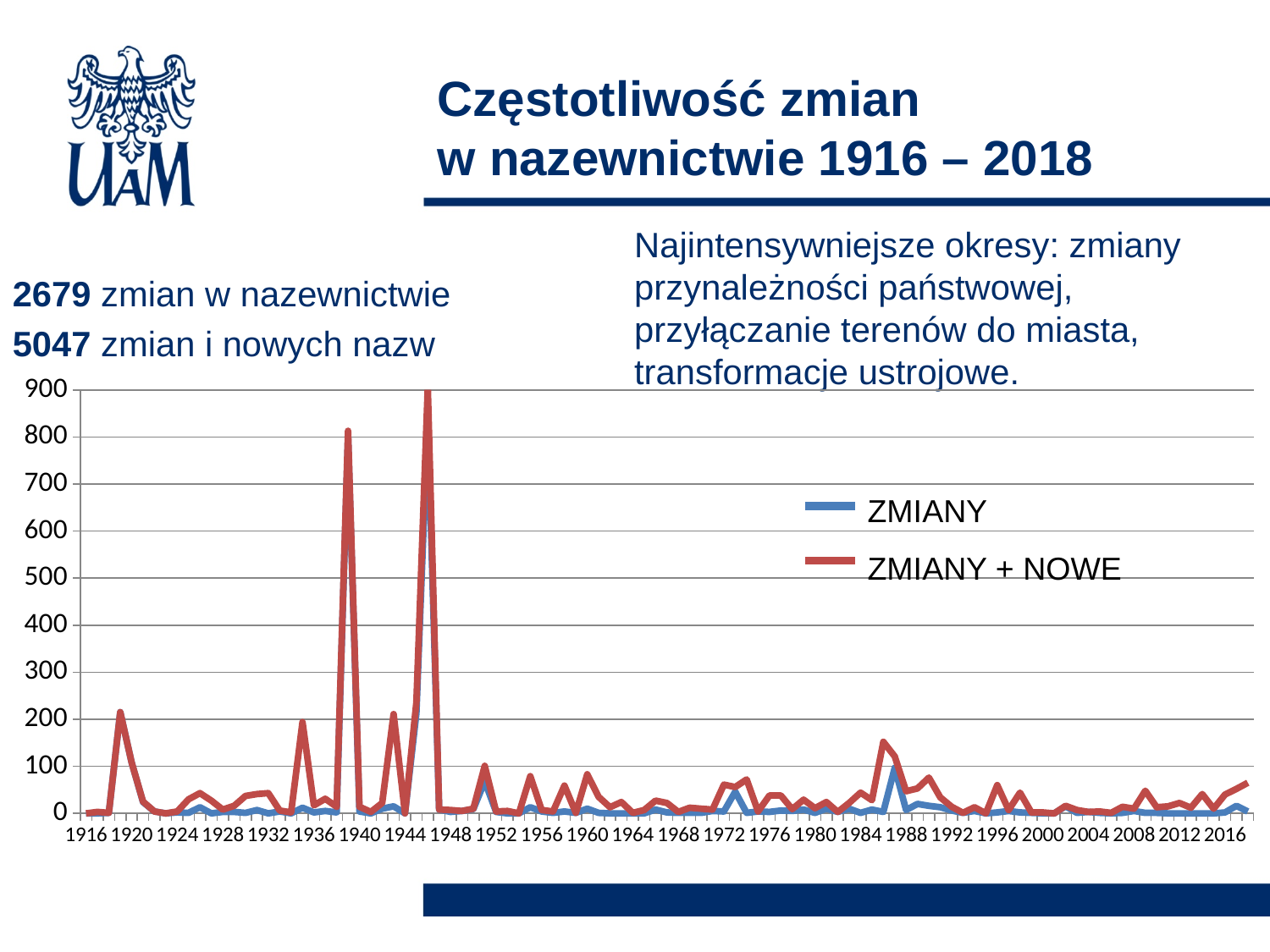
Is the value for ZMIANY + NOWE in 1916 greater or less than 100? less How many series does the chart legend list? 2 What is the highest value shown on the chart's vertical axis? 900 What kind of chart is shown on the slide? line chart Which colour is used for the ZMIANY + NOWE series? red Are the peaks of ZMIANY + NOWE after 1950 higher or lower than the peaks in the late 1930s and 1940s? lower Is the highest peak of the ZMIANY + NOWE series greater or less than 800? greater Is the value for ZMIANY in 2016 greater or less than 100? less What is the first year labelled on the chart's horizontal axis? 1916 What are the two series named in the chart legend? ZMIANY and ZMIANY + NOWE